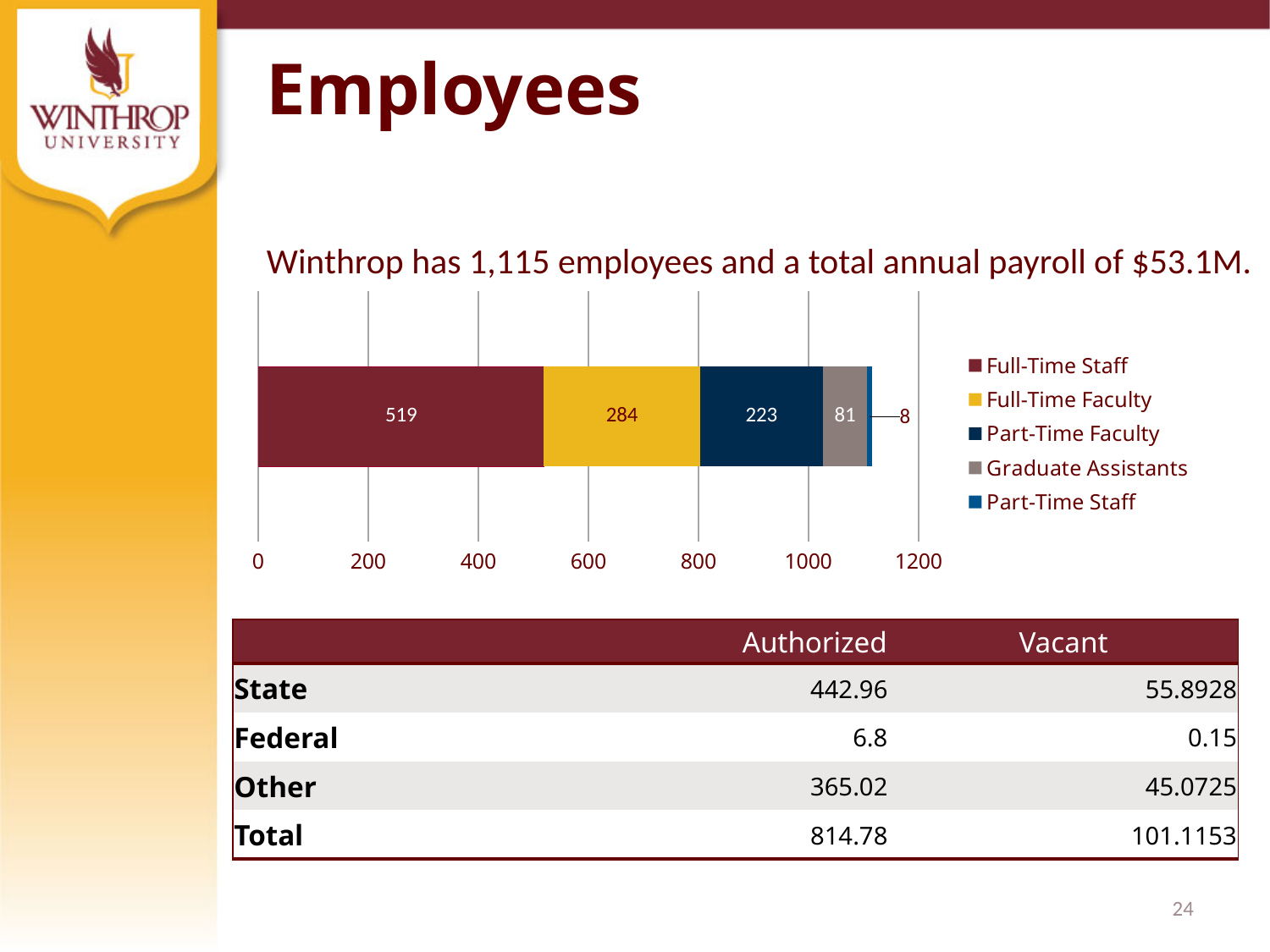
How many series does the chart legend list? 5 Which employee group has the smallest value in the chart? Part-Time Staff What is the value for Full-Time Staff in the chart? 519 Which employee group has the largest value in the chart? Full-Time Staff Which is larger in the chart, Part-Time Faculty or Graduate Assistants? Part-Time Faculty What is the difference between the Full-Time Staff and Full-Time Faculty values in the chart? 235 What kind of chart is shown on the slide? Stacked bar chart What is the value for Full-Time Faculty in the chart? 284 What is the value for Part-Time Staff in the chart? 8 What is the total of all segments in the stacked bar? 1115 What is the value for Part-Time Faculty in the chart? 223 What is the value for Graduate Assistants in the chart? 81